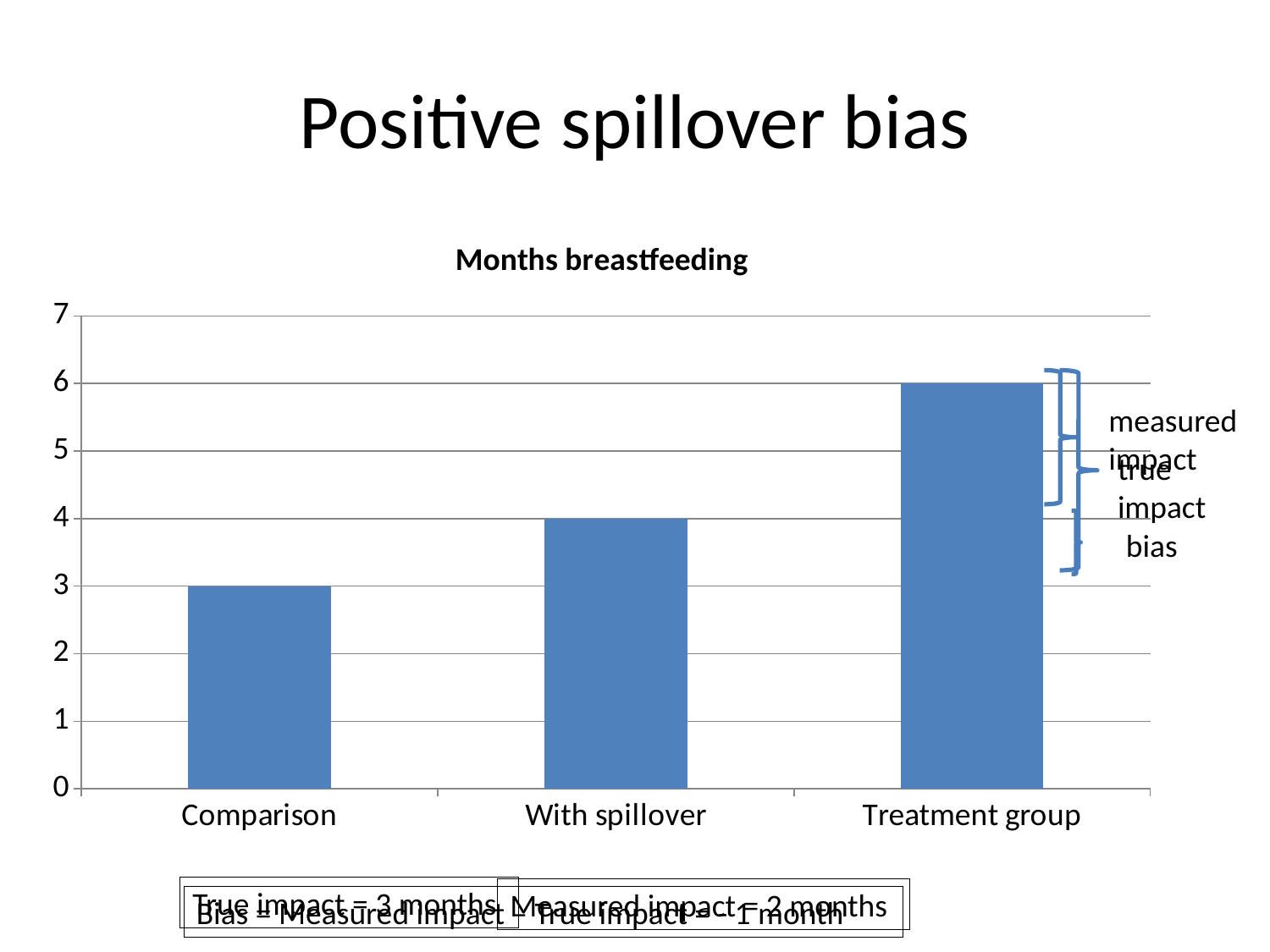
What kind of chart is shown on the slide? bar chart What is the difference between the With spillover value and the Comparison value? 1 What is the title of the chart? Months breastfeeding What is the value for the Comparison bar? 3 Do the values rise or fall from left to right along the x axis? rise What is the value for the Treatment group bar? 6 Which category has the lowest value? Comparison What is the difference between the Treatment group value and the Comparison value? 3 Which category has the highest value? Treatment group Which is larger, the value for With spillover or the value for Comparison? With spillover How many categories are shown on the x axis of the chart? 3 What is the value for the With spillover bar? 4